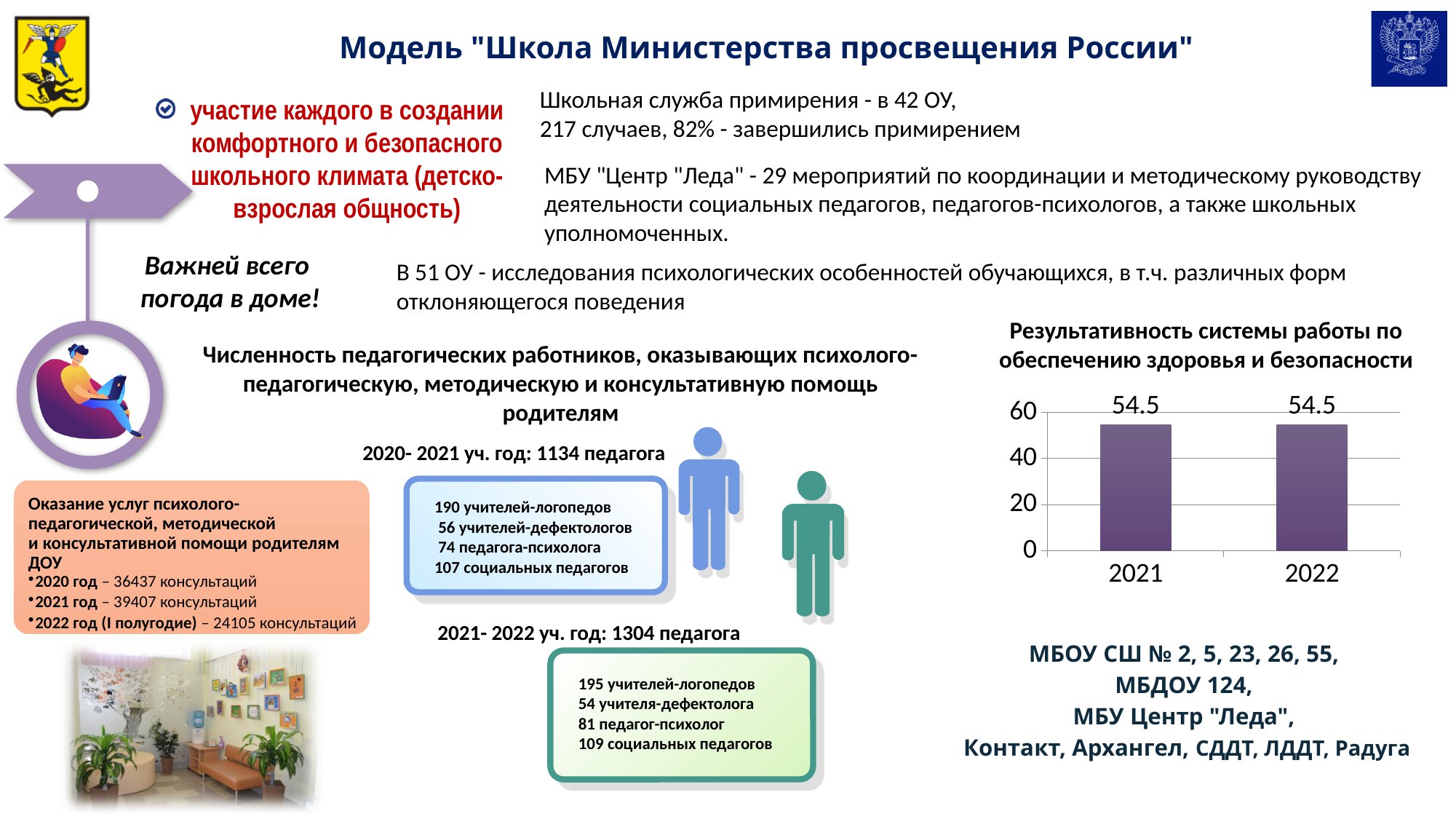
What is the value for 2022 in the chart "Результативность системы работы по обеспечению здоровья и безопасности"? 54.5 What is the difference between the 2022 and 2021 values in the chart "Результативность системы работы по обеспечению здоровья и безопасности"? 0 What is the value for 2021 in the chart "Результативность системы работы по обеспечению здоровья и безопасности"? 54.5 Is the value for 2022 larger than, smaller than, or equal to the value for 2021 in the chart "Результативность системы работы по обеспечению здоровья и безопасности"? equal How many categories are shown on the x axis of the chart "Результативность системы работы по обеспечению здоровья и безопасности"? 2 What is the title of the bar chart on the right side of the slide? Результативность системы работы по обеспечению здоровья и безопасности Do the values in the chart "Результативность системы работы по обеспечению здоровья и безопасности" rise, fall or stay the same from 2021 to 2022? stay the same Is the value for 2021 in the chart "Результативность системы работы по обеспечению здоровья и безопасности" greater or less than 40? greater What is the highest tick value shown on the y axis of the chart "Результативность системы работы по обеспечению здоровья и безопасности"? 60 What kind of chart is "Результативность системы работы по обеспечению здоровья и безопасности"? bar chart Is the value for 2022 in the chart "Результативность системы работы по обеспечению здоровья и безопасности" greater or less than 60? less